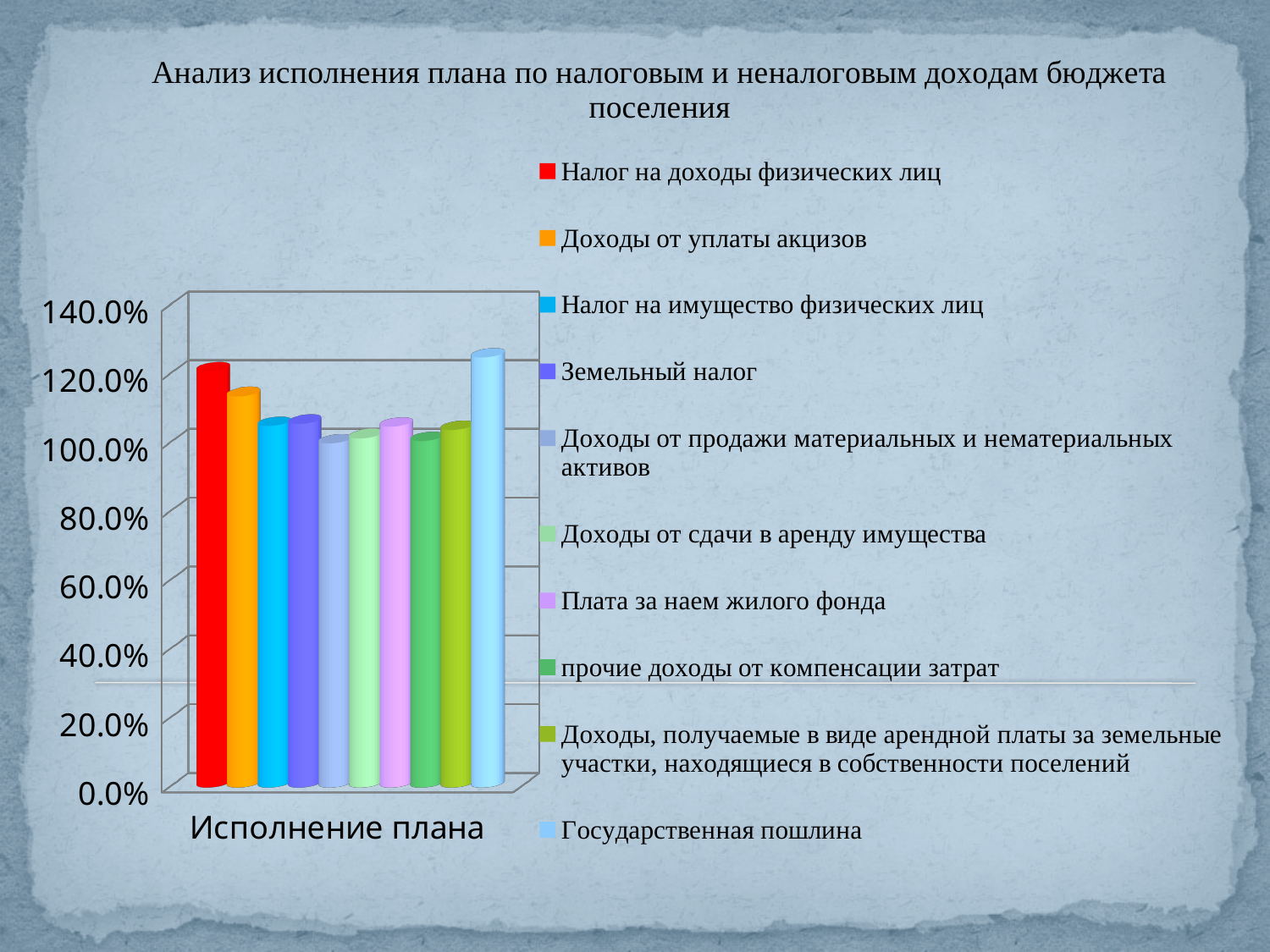
Is the value for Доходы от уплаты акцизов greater or less than 120%? less What is the label of the category on the x axis? Исполнение плана Which is larger, the value for Государственная пошлина or the value for Налог на имущество физических лиц? Государственная пошлина Which is larger, the value for Налог на доходы физических лиц or the value for Доходы от уплаты акцизов? Налог на доходы физических лиц How many categories are shown on the x axis? 1 Which series has the highest value? Государственная пошлина Is the value for Государственная пошлина greater or less than 120%? greater How many series does the legend list? 10 What colour is the bar for Налог на доходы физических лиц? red Is the value for Плата за наем жилого фонда greater or less than 120%? less What kind of chart is shown on the slide? bar chart